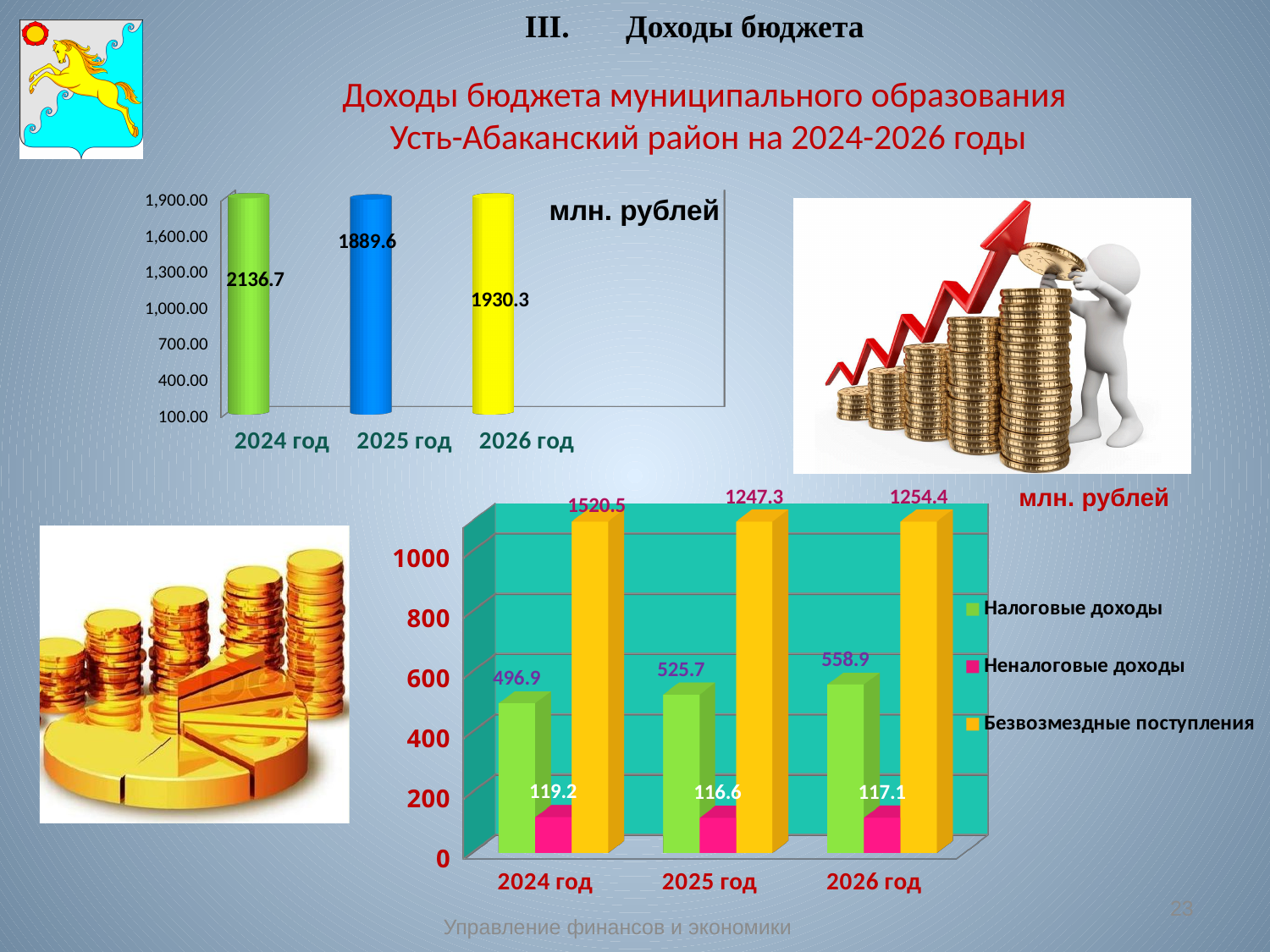
In the top-left chart, what is the value for 2025 год? 1889.6 In the bottom chart, what is the value of Неналоговые доходы for 2025 год? 116.6 In the bottom chart, what is the value of Налоговые доходы for 2026 год? 558.9 In the top-left chart, what is the difference between the values for 2024 год and 2026 год? 206.4 In the top-left chart, what is the value for 2024 год? 2136.7 In the top-left chart, how many years are shown on the x axis? 3 In the bottom chart, how many series does the legend list? 3 In the bottom chart, do the values of Налоговые доходы rise or fall from 2024 год to 2026 год? rise In the top-left chart, which year has the highest value? 2024 год In the bottom chart, which is larger for 2025 год: Налоговые доходы or Безвозмездные поступления? Безвозмездные поступления In the top-left chart, which year has the lowest value? 2025 год In the bottom chart, what is the value of Безвозмездные поступления for 2024 год? 1520.5